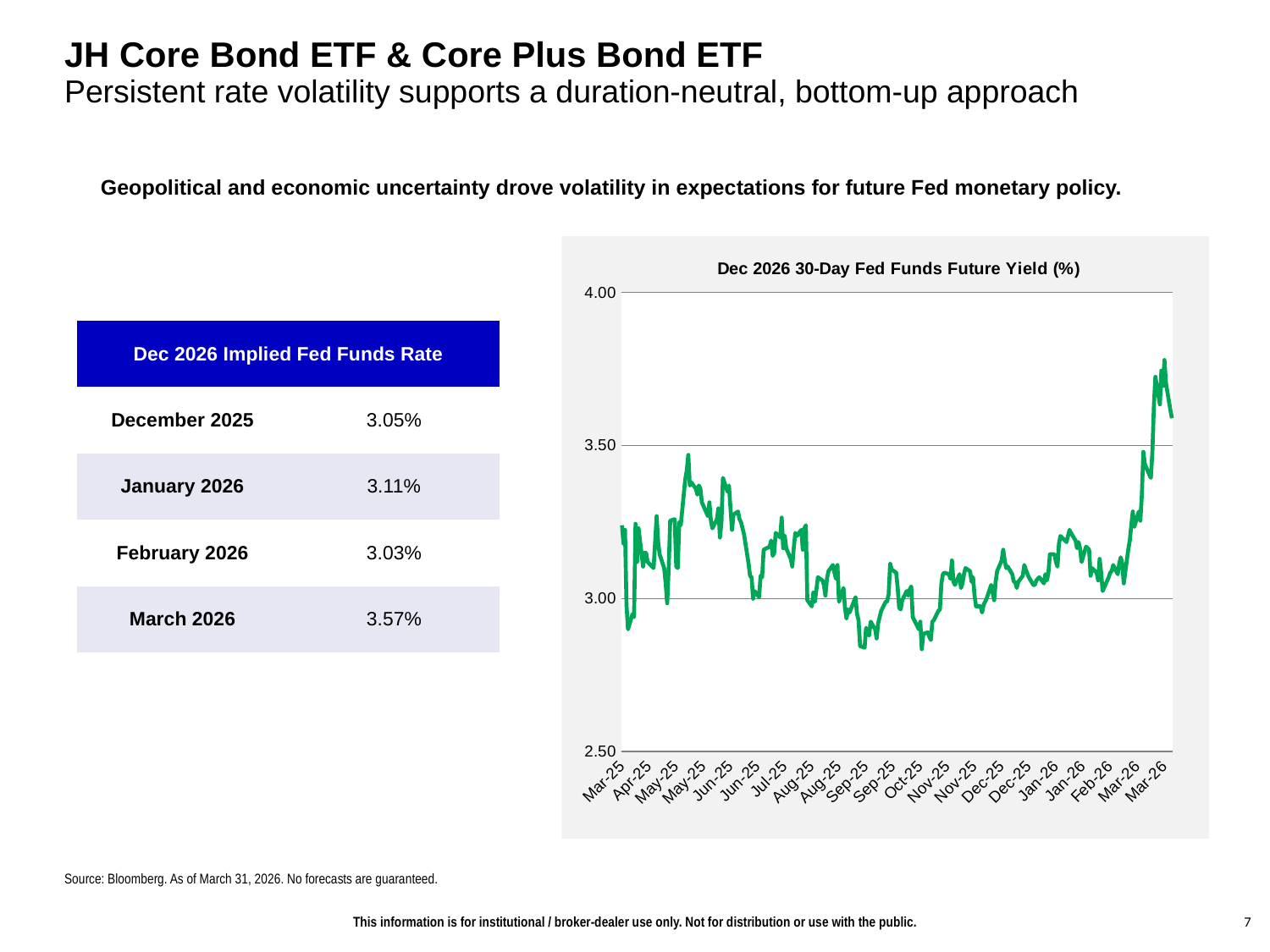
In the Dec 2026 30-Day Fed Funds Future Yield chart, is the value at the end of the series (Mar-26) greater or less than 3.50? greater In the Dec 2026 30-Day Fed Funds Future Yield chart, does the yield rise or fall between May-25 and Sep-25? fall What kind of chart is shown on the slide? line chart What is the lowest value shown on the y-axis of the Dec 2026 30-Day Fed Funds Future Yield chart? 2.50 In the Dec 2026 30-Day Fed Funds Future Yield chart, is the highest point of the line greater or less than 3.50? greater In the Dec 2026 30-Day Fed Funds Future Yield chart, does the yield rise or fall between Oct-25 and Mar-26? rise In the Dec 2026 30-Day Fed Funds Future Yield chart, which is higher: the value at Mar-26 or the value at Oct-25? Mar-26 In the Dec 2026 30-Day Fed Funds Future Yield chart, does the line ever reach 4.00? No How many lines are plotted in the Dec 2026 30-Day Fed Funds Future Yield chart? 1 What is the title of the chart on the slide? Dec 2026 30-Day Fed Funds Future Yield (%)